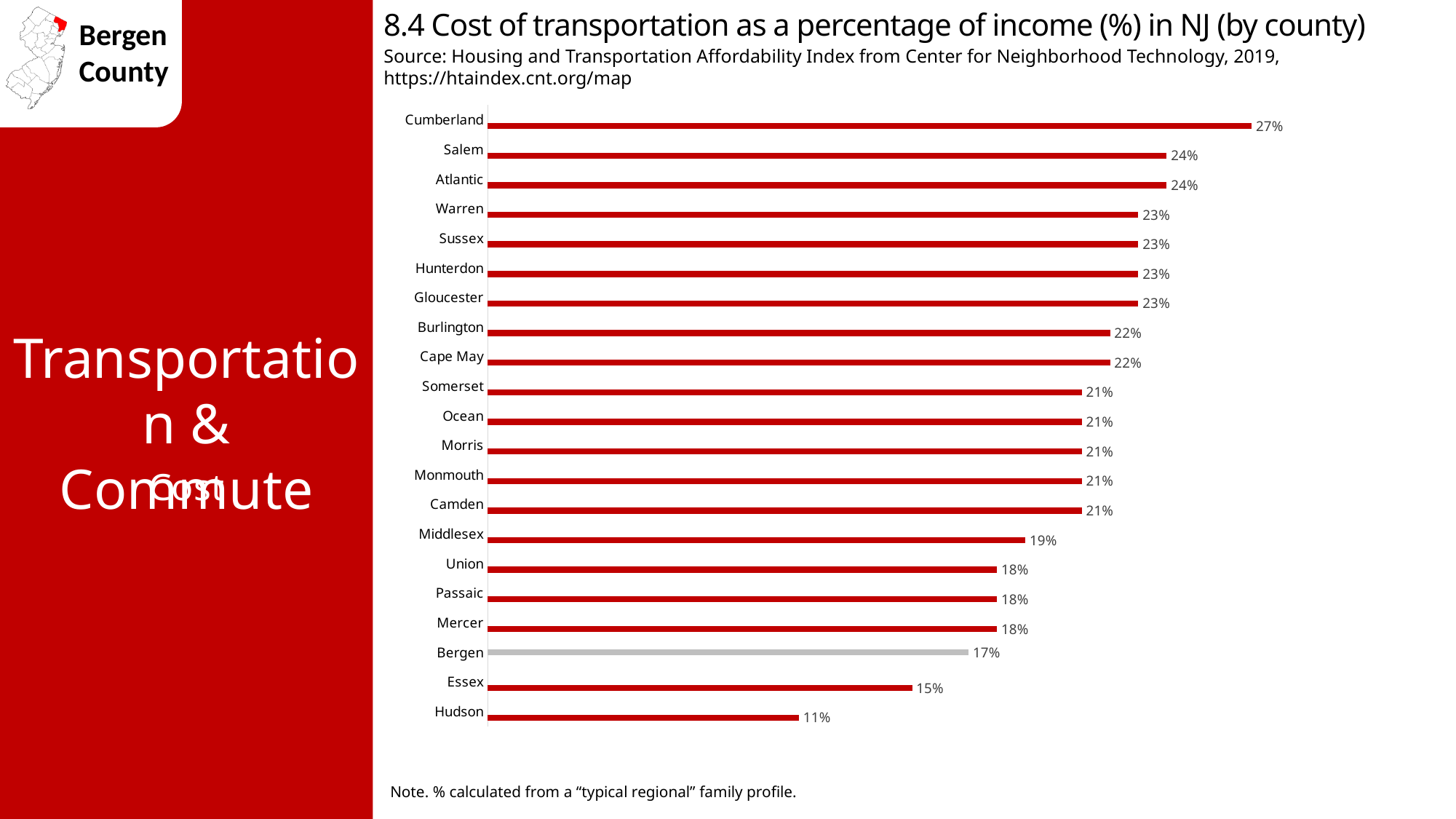
What is the value shown for Hudson County? 11% What is the cost of transportation as a percentage of income for Bergen County? 17% Which county has the highest cost of transportation as a percentage of income? Cumberland What is the difference between the values for Essex and Hudson? 4% Which has a higher value, Salem or Burlington? Salem What is the value shown for Middlesex County? 19% Which county's bar is shown in grey instead of red? Bergen How many counties are shown in the chart? 21 Which county has the lowest cost of transportation as a percentage of income? Hudson What is the difference between the values for Cumberland and Bergen? 10% What kind of chart is shown on the slide? Bar chart Which has a higher value, Bergen or Union? Union